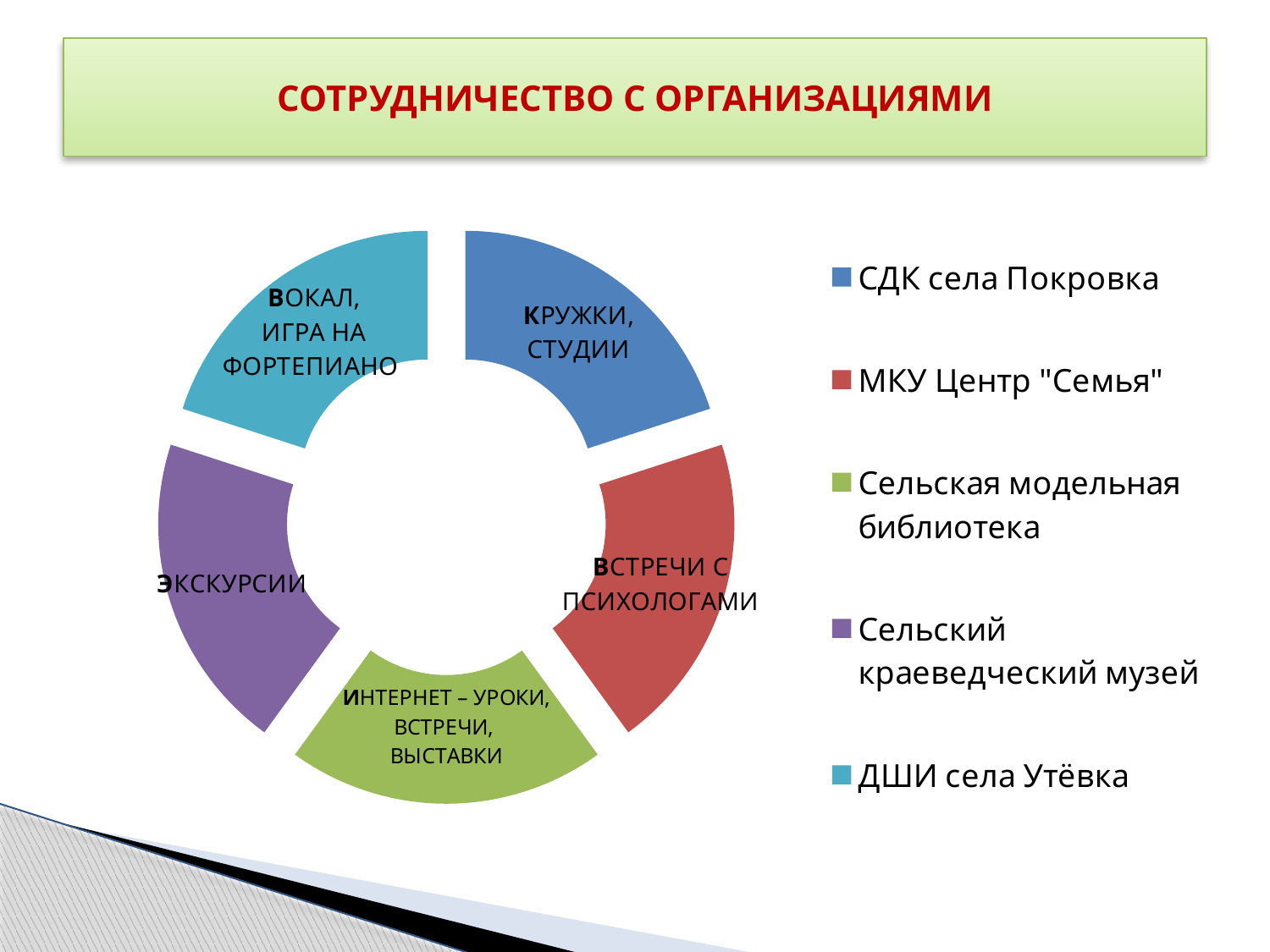
How many entries does the legend list? 5 How many segments does the doughnut chart have? 5 What label is written on the dark blue segment of the doughnut chart? КРУЖКИ, СТУДИИ What label is written on the green segment of the doughnut chart? ИНТЕРНЕТ – УРОКИ, ВСТРЕЧИ, ВЫСТАВКИ Which legend entry is shown in blue? СДК села Покровка What label is written on the light blue (cyan) segment of the doughnut chart? ВОКАЛ, ИГРА НА ФОРТЕПИАНО Which legend entry corresponds to the light blue (cyan) segment? ДШИ села Утёвка What label is written on the purple segment of the doughnut chart? ЭКСКУРСИИ Which legend entry corresponds to the red segment? МКУ Центр "Семья" What kind of chart is shown on the slide? Doughnut chart What label is written on the red segment of the doughnut chart? ВСТРЕЧИ С ПСИХОЛОГАМИ What is the title of the slide above the chart? СОТРУДНИЧЕСТВО С ОРГАНИЗАЦИЯМИ